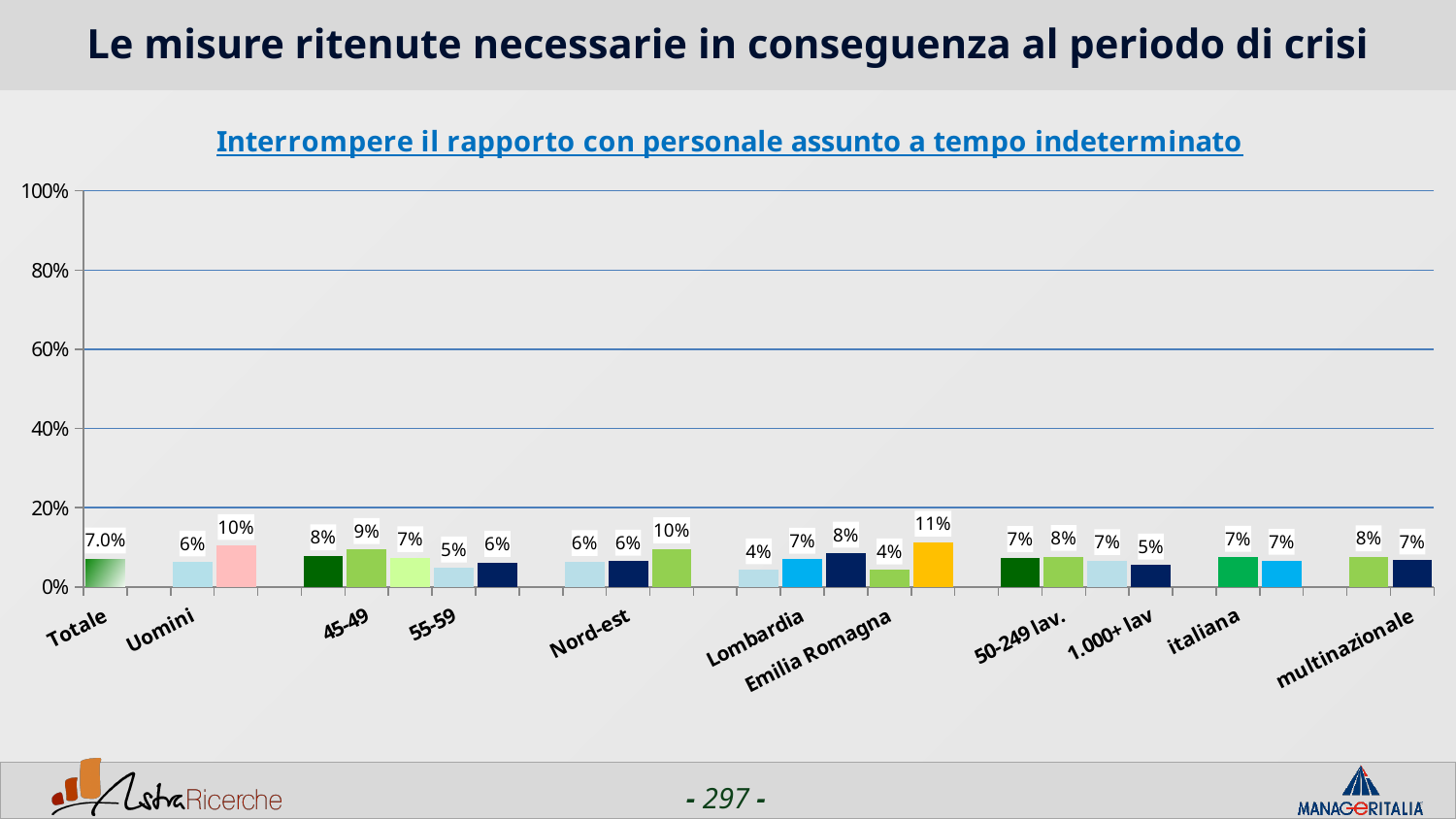
What is the subtitle of the chart, shown above the plot area? Interrompere il rapporto con personale assunto a tempo indeterminato What is the value for italiana? 7% Is the value for Totale greater or less than 20%? less What kind of chart is shown on the slide? bar chart What is the difference between the value for italiana and the value for 55-59? 2% What is the value for Uomini? 6% What is the value for 55-59? 5% What is the highest value shown by any data label on the chart? 11% What is the value for Nord-est? 6% What is the value for Totale? 7.0% What is the value for 1.000+ lav? 5% Which is larger, the value for Totale or the value for Uomini? Totale